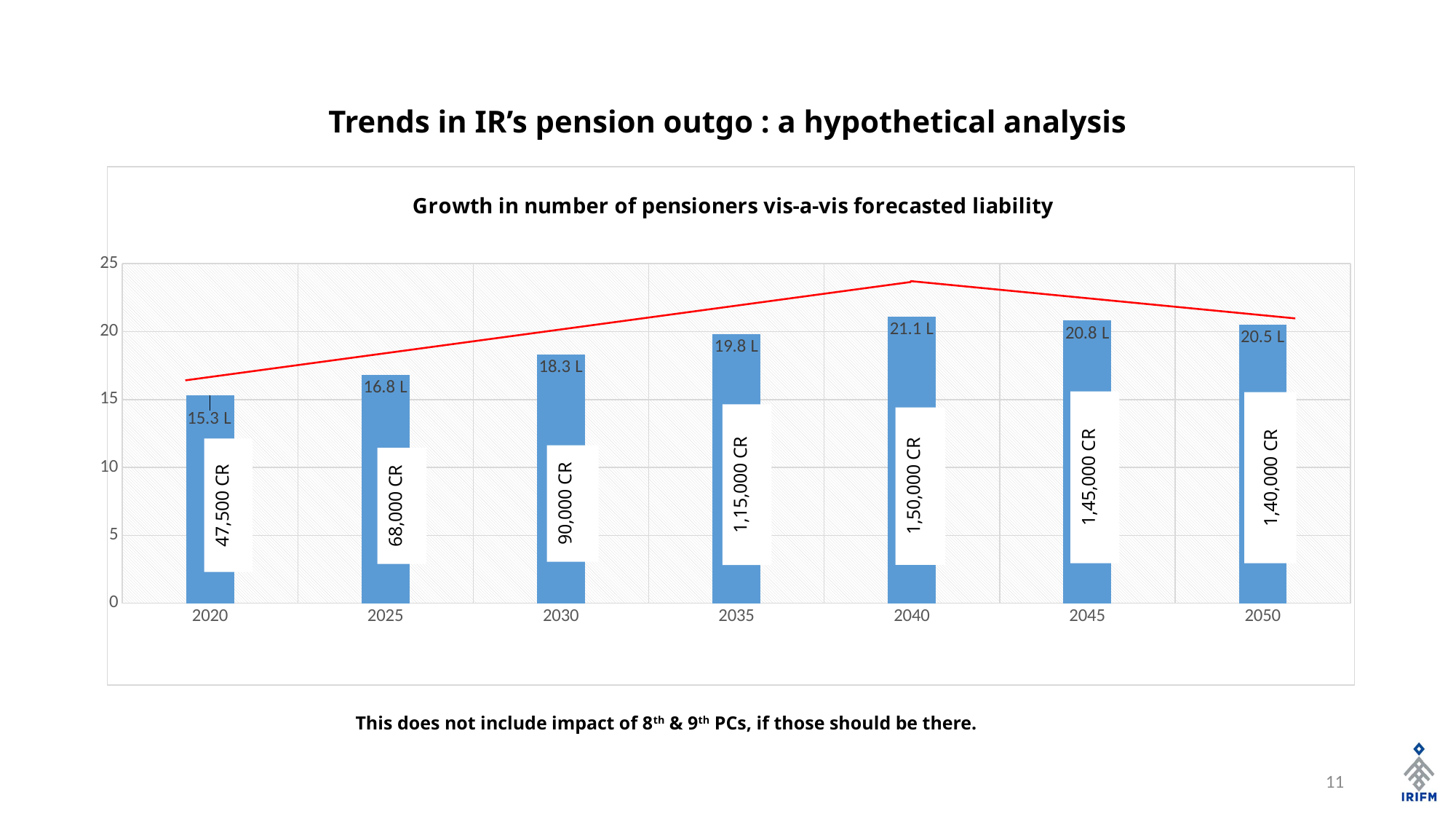
Do the bar values rise or fall from 2020 to 2040? rise What is the number of pensioners shown for 2020? 15.3 L What is the number of pensioners shown for 2040? 21.1 L What is the difference in the number of pensioners between 2030 and 2020? 3 L How many years are shown on the x axis? 7 What is the forecasted liability shown for 2035? 1,15,000 CR What is the chart's title? Growth in number of pensioners vis-a-vis forecasted liability What is the forecasted liability shown for 2050? 1,40,000 CR Which year has the larger number of pensioners, 2025 or 2045? 2045 What type of chart is used to show the number of pensioners? bar chart Which year has the highest number of pensioners? 2040 Which year has the lowest number of pensioners? 2020